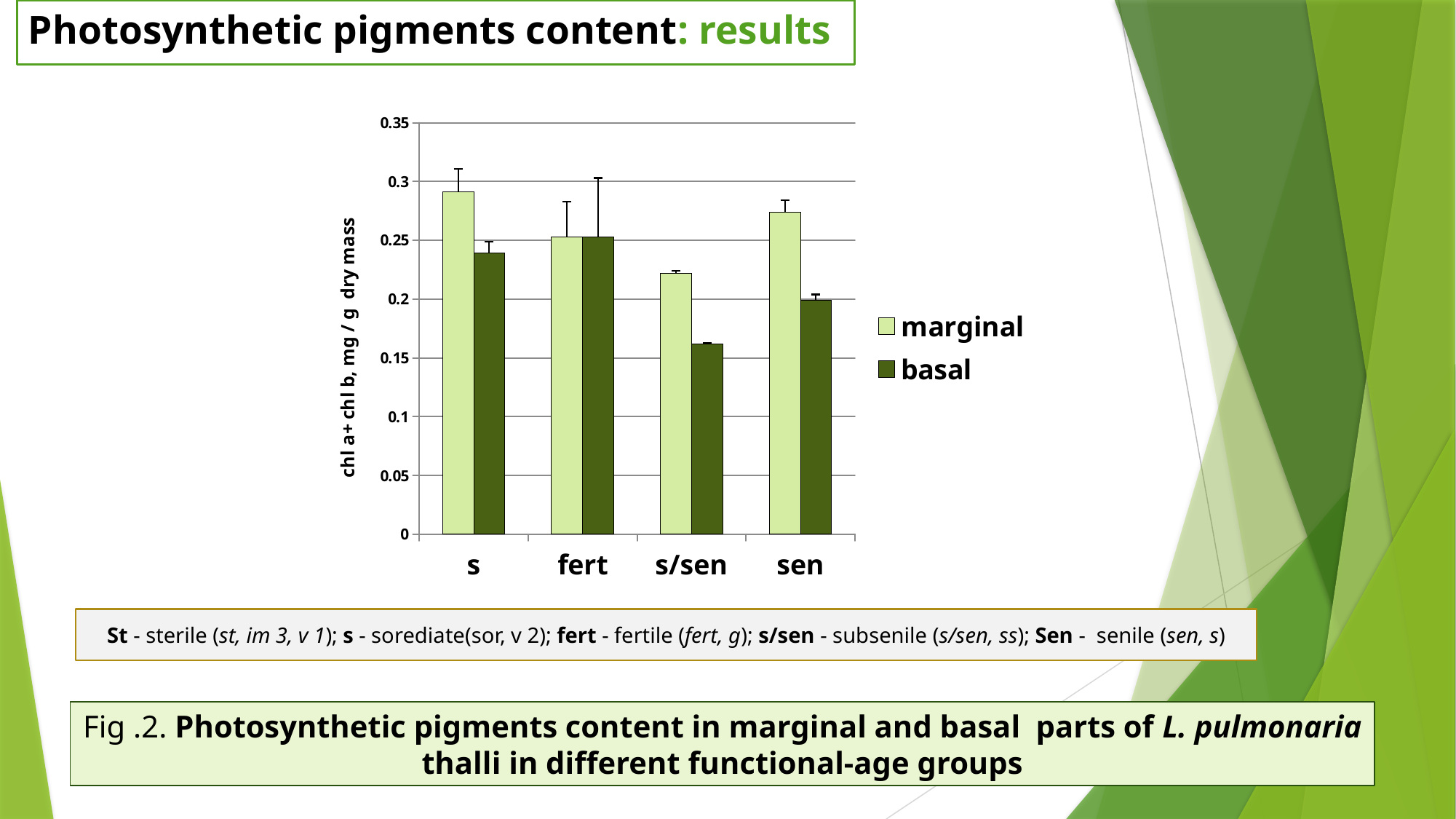
For the s/sen group, which is larger, the marginal or the basal value? marginal How many functional-age groups are shown on the x axis of the chart? 4 What is the label of the vertical axis of the chart? chl a+ chl b, mg / g dry mass Is the marginal value for s/sen greater or less than 0.2? greater What are the two series named in the chart legend? marginal and basal Which group has the lowest basal value? s/sen How many series does the chart legend list? 2 Is the marginal value for sen greater or less than 0.25? greater For the s group, which is larger, the marginal or the basal value? marginal What kind of chart is shown on the slide? bar chart Is the basal value for s/sen greater or less than 0.2? less